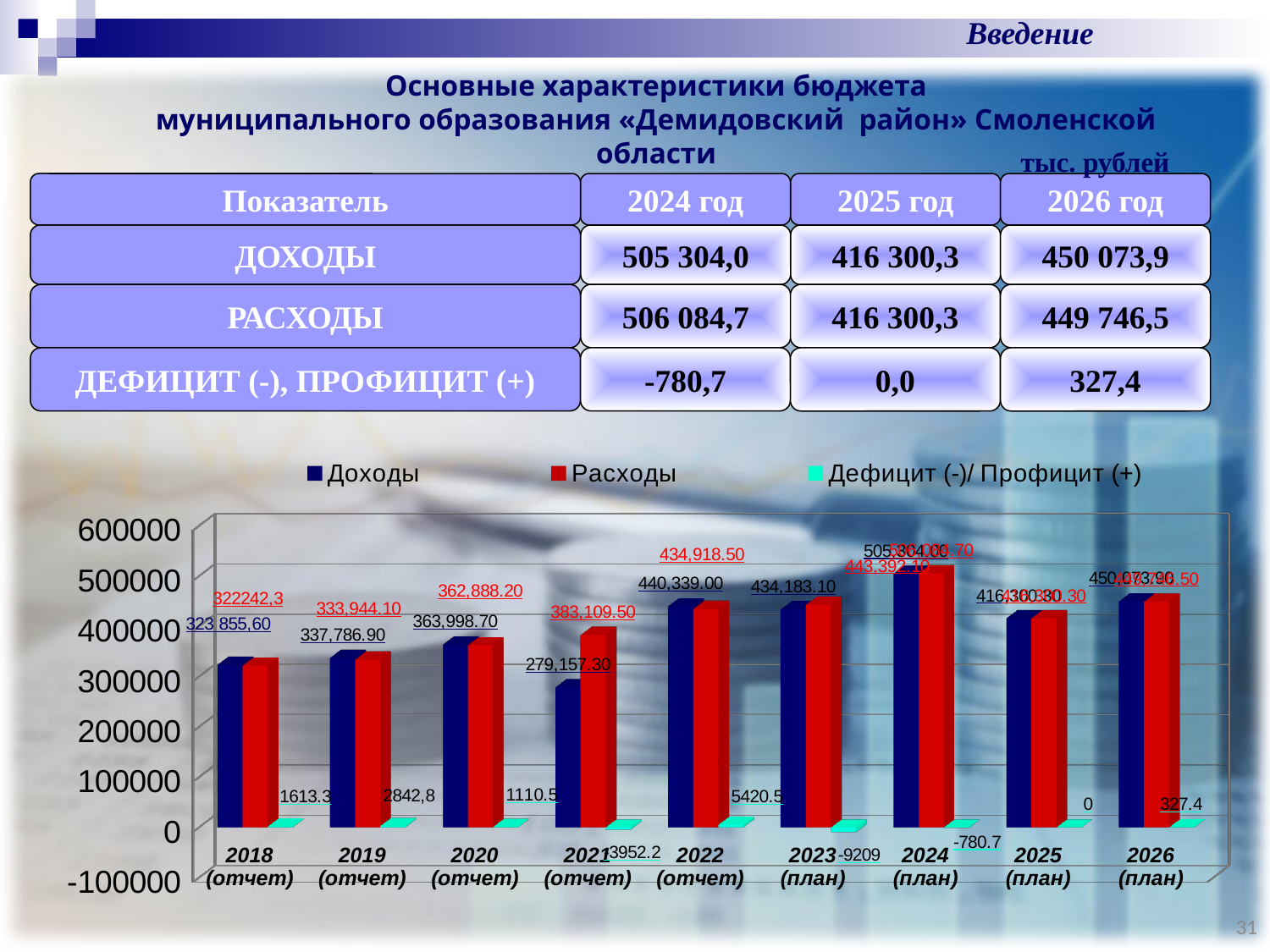
In the chart, is the Доходы value for 2021 (отчет) greater or less than 300000? less What is the value of Расходы for 2021 (отчет) in the chart? 383,109.50 What is the value of Дефицит (-)/Профицит (+) for 2023 (план) in the chart? -9209 Which year has the lowest Доходы value in the chart? 2021 (отчет) Which series in the chart legend is shown in red? Расходы What is the value of Доходы for 2022 (отчет) in the chart? 440,339.00 In the chart, is the Расходы value for 2022 (отчет) greater or less than 400000? greater What is the value of Доходы for 2019 (отчет) in the chart? 337,786.90 In the chart, which is larger for 2023 (план): Доходы or Расходы? Расходы How many year categories are shown along the x axis of the chart? 9 How many series does the chart legend list? 3 What type of chart is shown at the bottom of the slide? bar chart